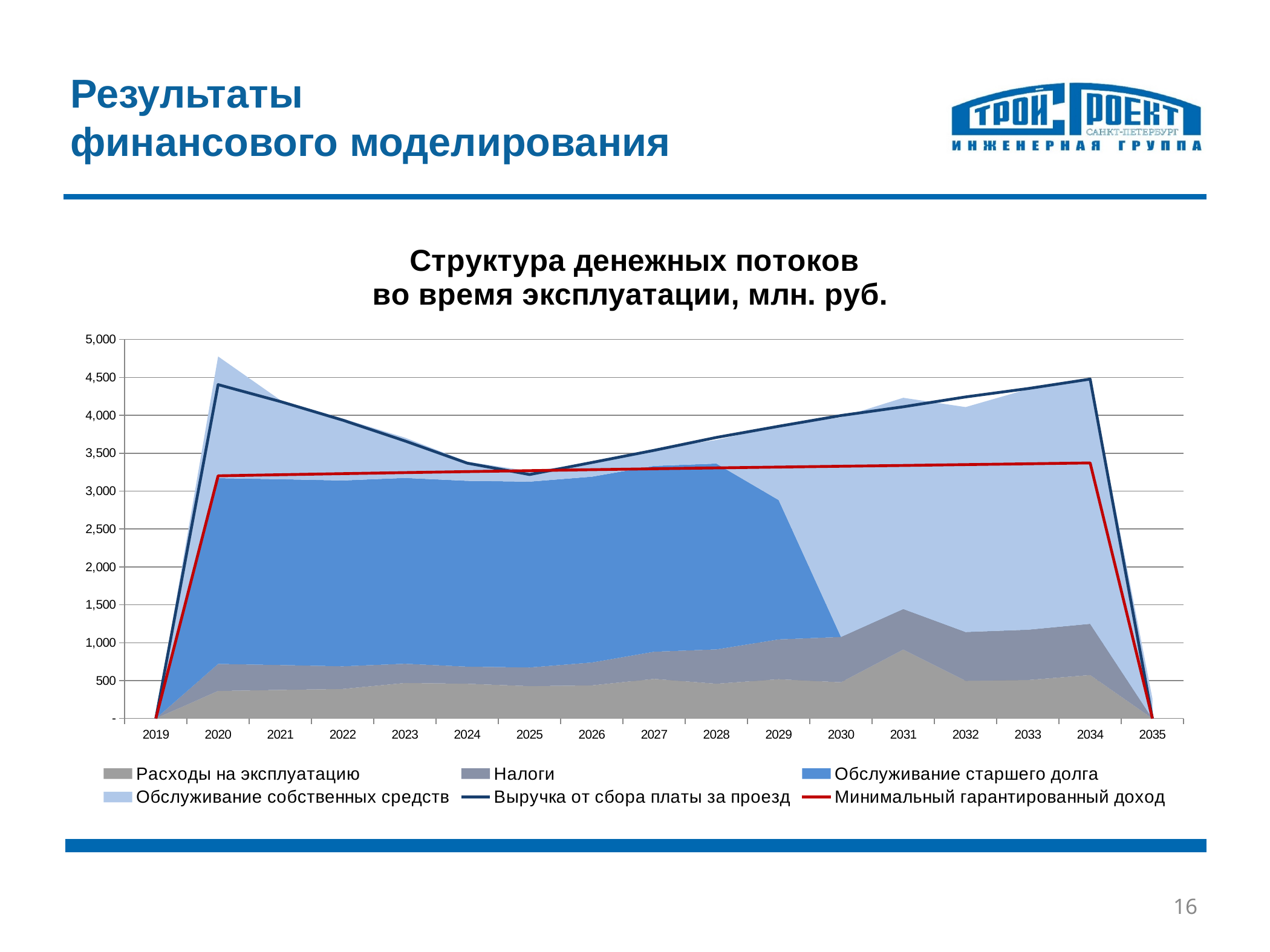
Is the value of Минимальный гарантированный доход in 2025 greater or less than 3,000? greater How many series does the legend list? 6 Does Выручка от сбора платы за проезд rise or fall from 2020 to 2025? fall How many years are shown on the x axis? 17 Is the value of Выручка от сбора платы за проезд in 2020 greater or less than 4,000? greater Between 2020 and 2034, in which year is Выручка от сбора платы за проезд lowest? 2025 Does Выручка от сбора платы за проезд rise or fall from 2025 to 2034? rise Is the value of Выручка от сбора платы за проезд in 2025 greater or less than 3,500? less What is the title of the chart? Структура денежных потоков во время эксплуатации, млн. руб. What kind of chart is shown on the slide? Stacked area chart with line series Which series is drawn as a red line? Минимальный гарантированный доход